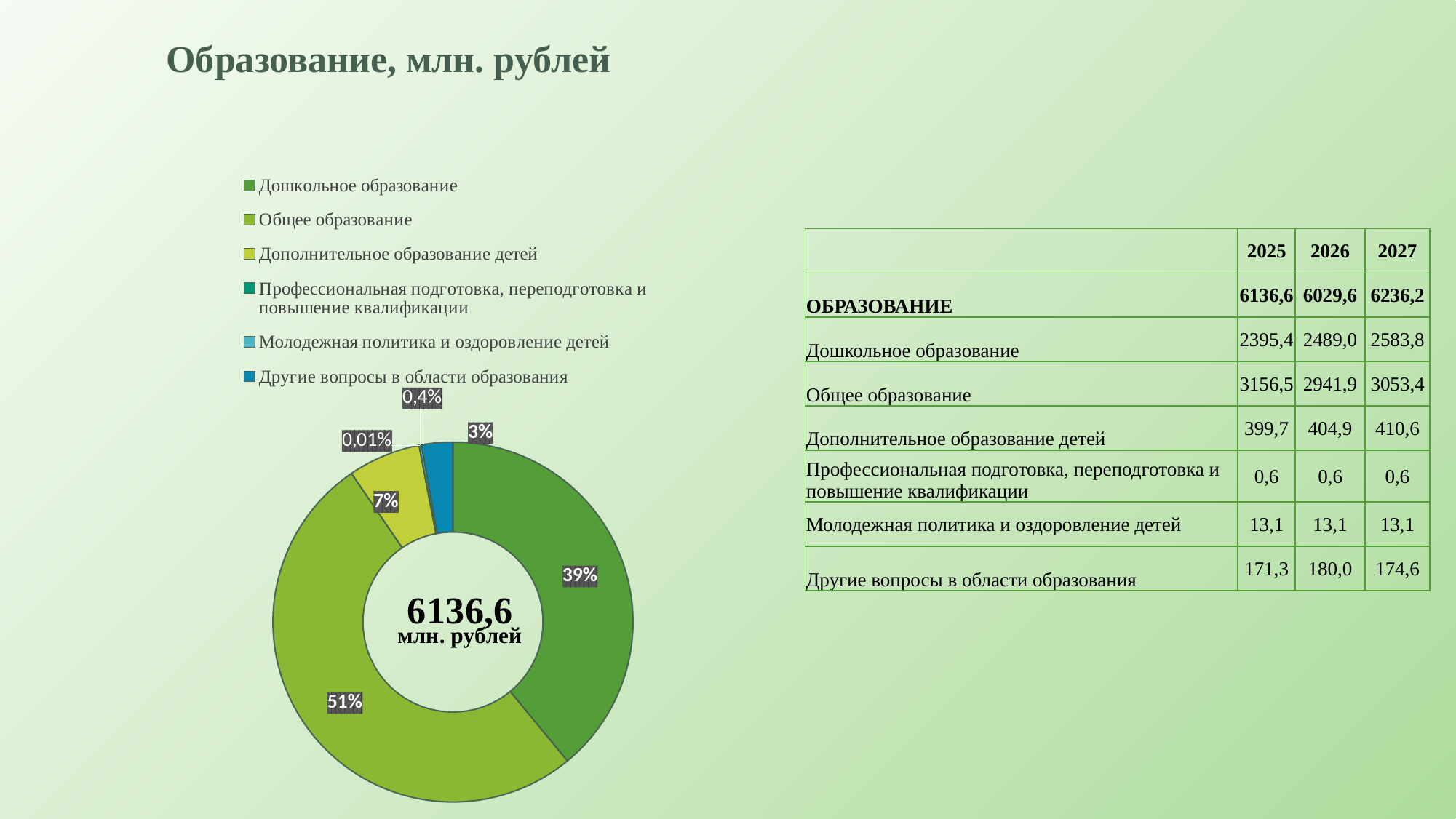
Which has a larger share of the doughnut chart: Дополнительное образование детей or Другие вопросы в области образования? Дополнительное образование детей Which category has the smallest share of the doughnut chart? Профессиональная подготовка, переподготовка и повышение квалификации What share of the doughnut chart does Дошкольное образование account for? 39% What percentage label is shown for Профессиональная подготовка, переподготовка и повышение квалификации on the doughnut chart? 0,01% What percentage label is shown for Дополнительное образование детей on the doughnut chart? 7% By how many percentage points does the share of Общее образование exceed the share of Дошкольное образование? 12% What share of the doughnut chart does Общее образование account for? 51% Which category has the largest share of the doughnut chart? Общее образование What percentage label is shown for Молодежная политика и оздоровление детей on the doughnut chart? 0,4% How many categories does the legend of the doughnut chart list? 6 What percentage label is shown for Другие вопросы в области образования on the doughnut chart? 3% What total value is printed in the centre of the doughnut chart? 6136,6 млн. рублей